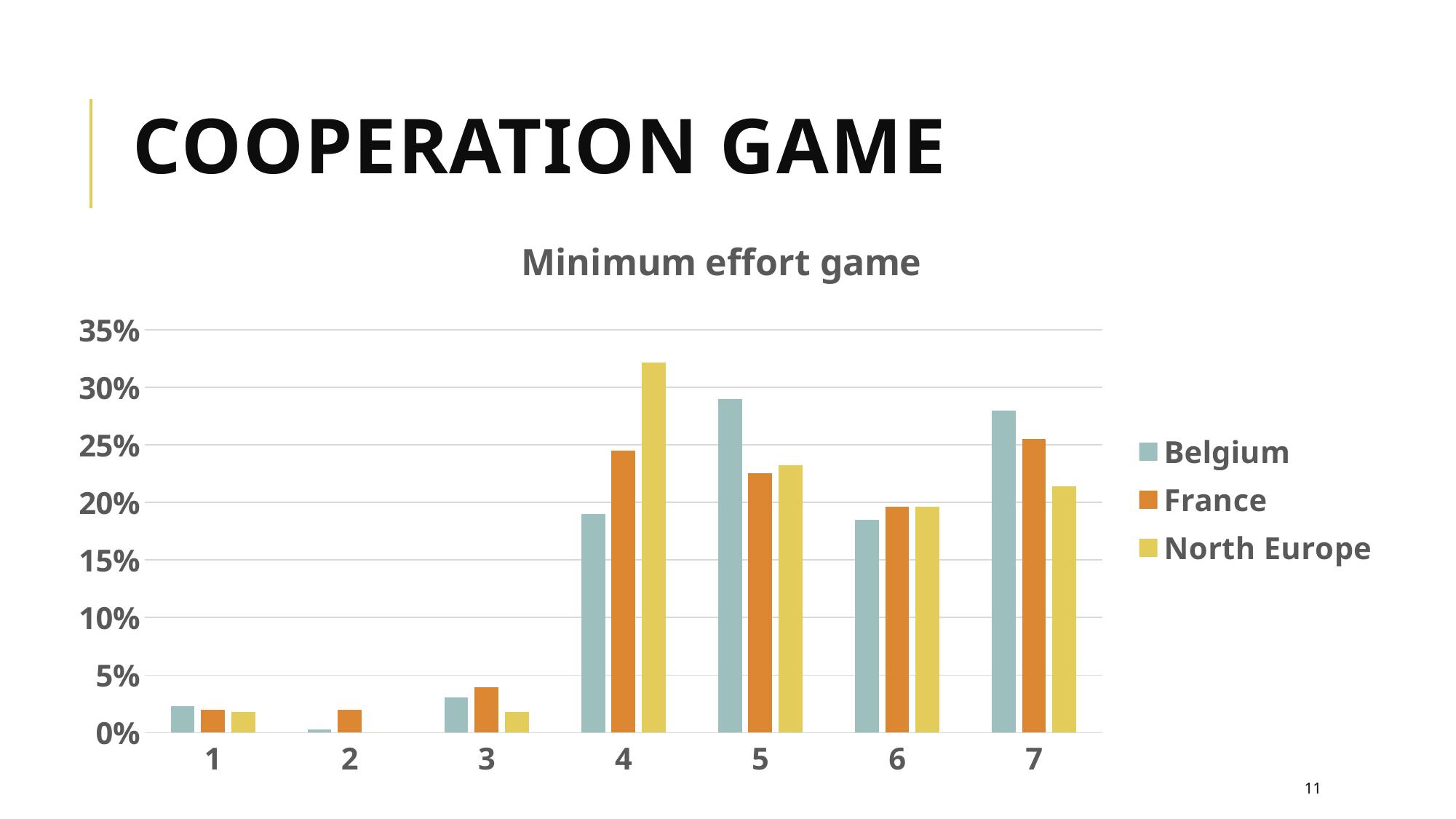
Which series are listed in the legend? Belgium, France, North Europe Is the Belgium value for category 4 greater or less than 20%? less What is the title of the chart? Minimum effort game How many series does the legend list? 3 For category 7, which is larger: the Belgium value or the North Europe value? Belgium Is the North Europe value for category 4 greater or less than 30%? greater For which category is the Belgium value lowest? 2 For category 5, which is larger: the Belgium value or the France value? Belgium What kind of chart is shown on the slide? bar chart How many categories are shown on the x axis? 7 Is the Belgium value for category 5 greater or less than 25%? greater For which category is the North Europe value highest? 4